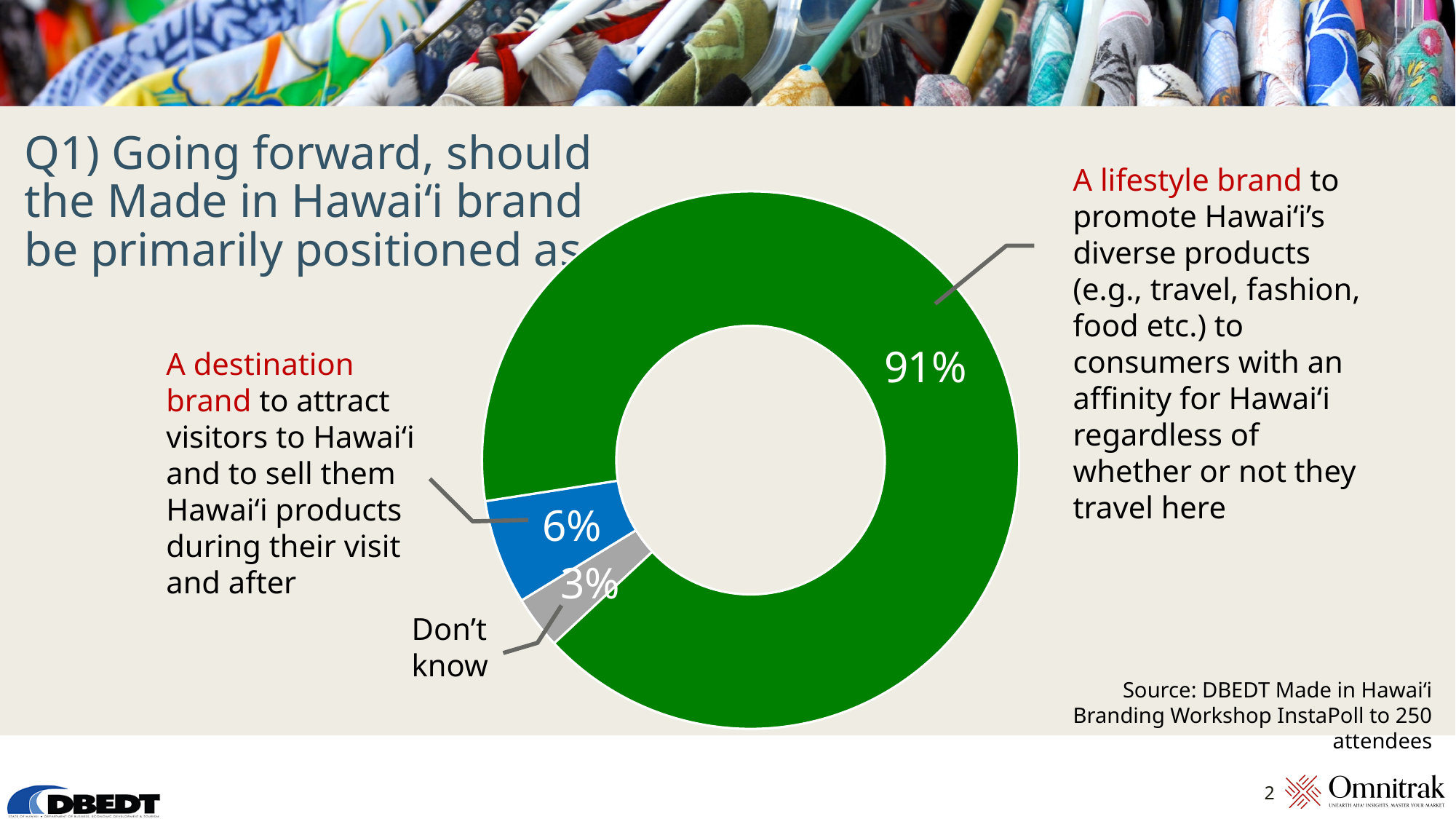
What kind of chart is shown on the slide? Pie chart (donut) What share of respondents answered Don't know? 3% What is the difference in percentage points between the destination brand share and the Don't know share? 3 What is the difference in percentage points between the lifestyle brand and destination brand shares? 85 Which option received the largest share of responses? A lifestyle brand What share of respondents chose a lifestyle brand? 91% Which option received the smallest share of responses? Don't know How many slices does the chart have? 3 What share of respondents chose a destination brand? 6% Which is larger, the share for a destination brand or the share for Don't know? A destination brand How many attendees were polled according to the source note? 250 What colour is the slice for a lifestyle brand? Green